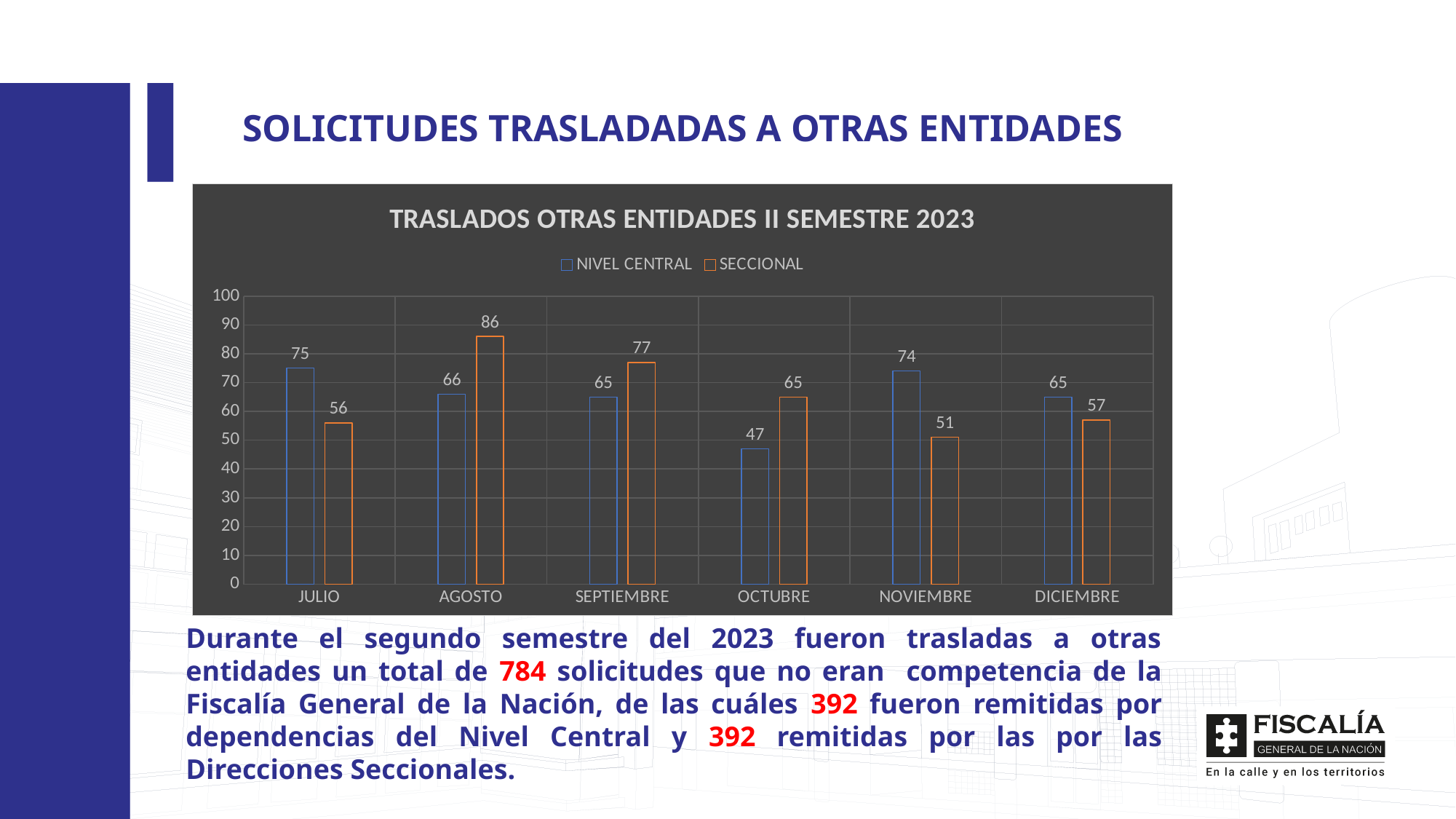
What is the difference between the SECCIONAL and NIVEL CENTRAL values for SEPTIEMBRE? 12 Which month has the highest SECCIONAL value? AGOSTO What is the NIVEL CENTRAL value for OCTUBRE? 47 How many months are shown on the x axis? 6 What is the NIVEL CENTRAL value for JULIO? 75 How many series does the legend list? 2 Is the SECCIONAL value for OCTUBRE greater or less than 60? greater Which is larger in NOVIEMBRE, NIVEL CENTRAL or SECCIONAL? NIVEL CENTRAL What is the title of the chart? TRASLADOS OTRAS ENTIDADES II SEMESTRE 2023 What kind of chart is shown? bar chart What is the SECCIONAL value for AGOSTO? 86 Which month has the lowest NIVEL CENTRAL value? OCTUBRE